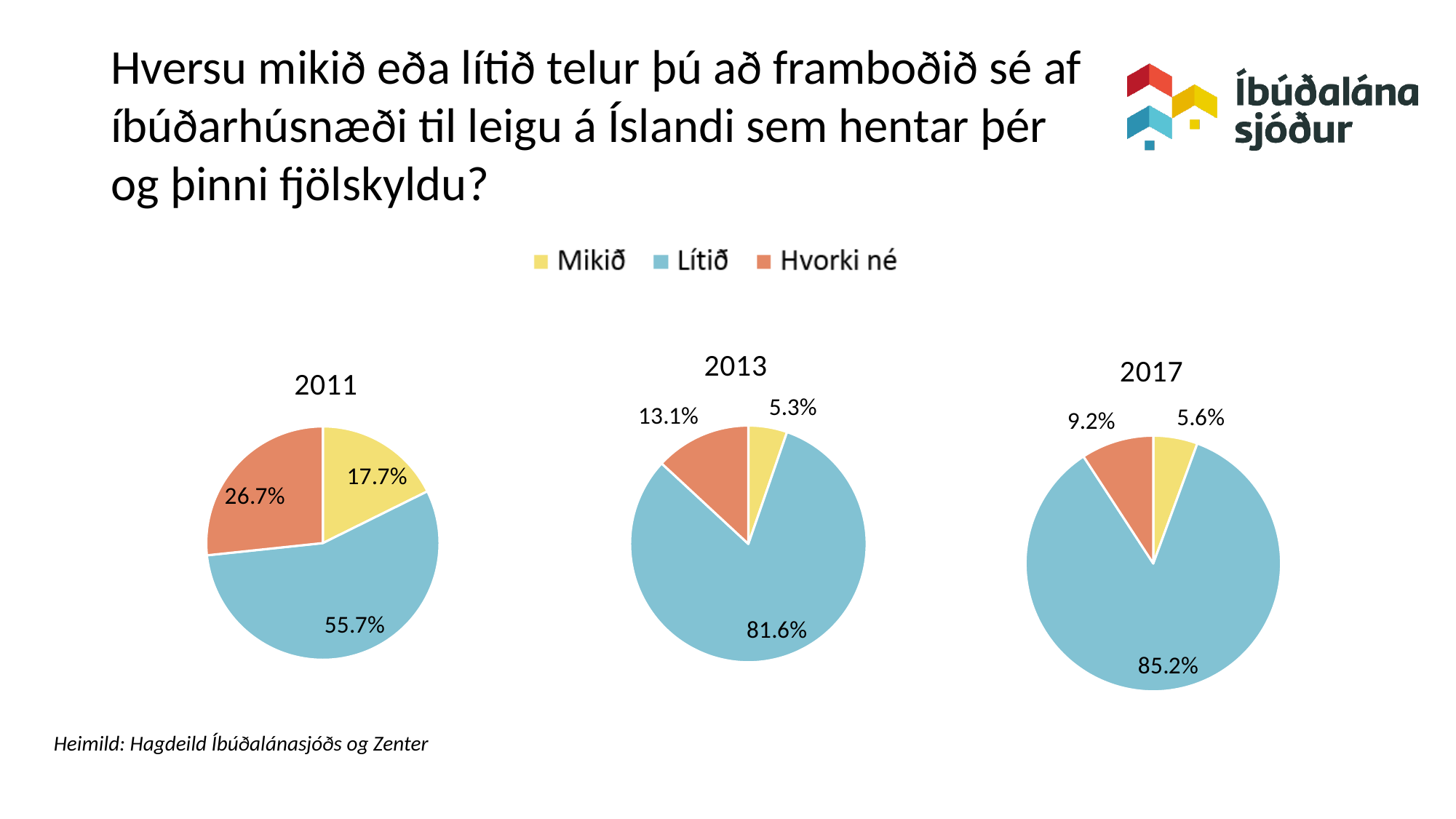
In the 2013 pie chart, what share is labelled for Mikið? 5.3% In the 2017 pie chart, what share is labelled for Lítið? 85.2% In the 2017 pie chart, what share is labelled for Hvorki né? 9.2% How many categories does the legend list? 3 In the 2011 pie chart, what share is labelled for Hvorki né? 26.7% In the 2011 pie chart, what share is labelled for Lítið? 55.7% In the 2011 pie chart, which category has the largest slice? Lítið What type of chart is used to show the 2013 data? Pie chart What is the difference between the Lítið share in the 2017 pie chart and the Lítið share in the 2011 pie chart? 29.5% In the 2013 pie chart, which category has the smallest slice? Mikið Which is larger: the Hvorki né share in the 2013 pie chart or the Hvorki né share in the 2017 pie chart? 2013 How many pie charts are shown on the slide? 3